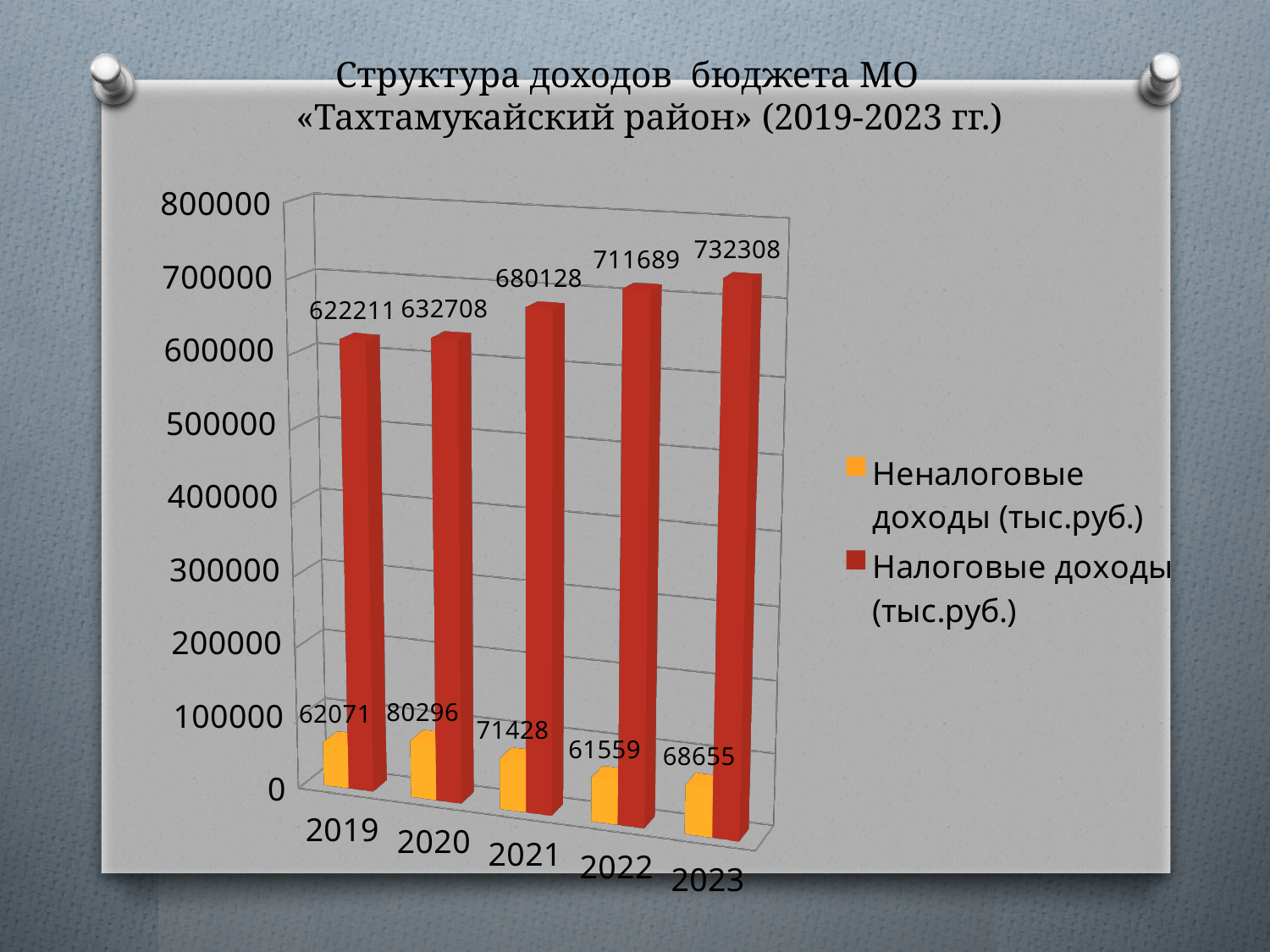
Which is larger: Неналоговые доходы (тыс.руб.) in 2021 or in 2023? 2021 What is the value of Неналоговые доходы (тыс.руб.) for 2020? 80296 What is the difference between Налоговые доходы (тыс.руб.) in 2023 and in 2019? 110097 Which year has the highest Налоговые доходы (тыс.руб.)? 2023 Which year has the lowest Неналоговые доходы (тыс.руб.)? 2022 How many series does the legend list? 2 Do the values of Налоговые доходы (тыс.руб.) rise or fall from 2019 to 2023? rise What kind of chart is shown on the slide? bar chart What is the value of Налоговые доходы (тыс.руб.) for 2023? 732308 Is the value of Налоговые доходы (тыс.руб.) for 2022 greater or less than 700000? greater What is the value of Налоговые доходы (тыс.руб.) for 2021? 680128 How many years are shown on the x axis? 5